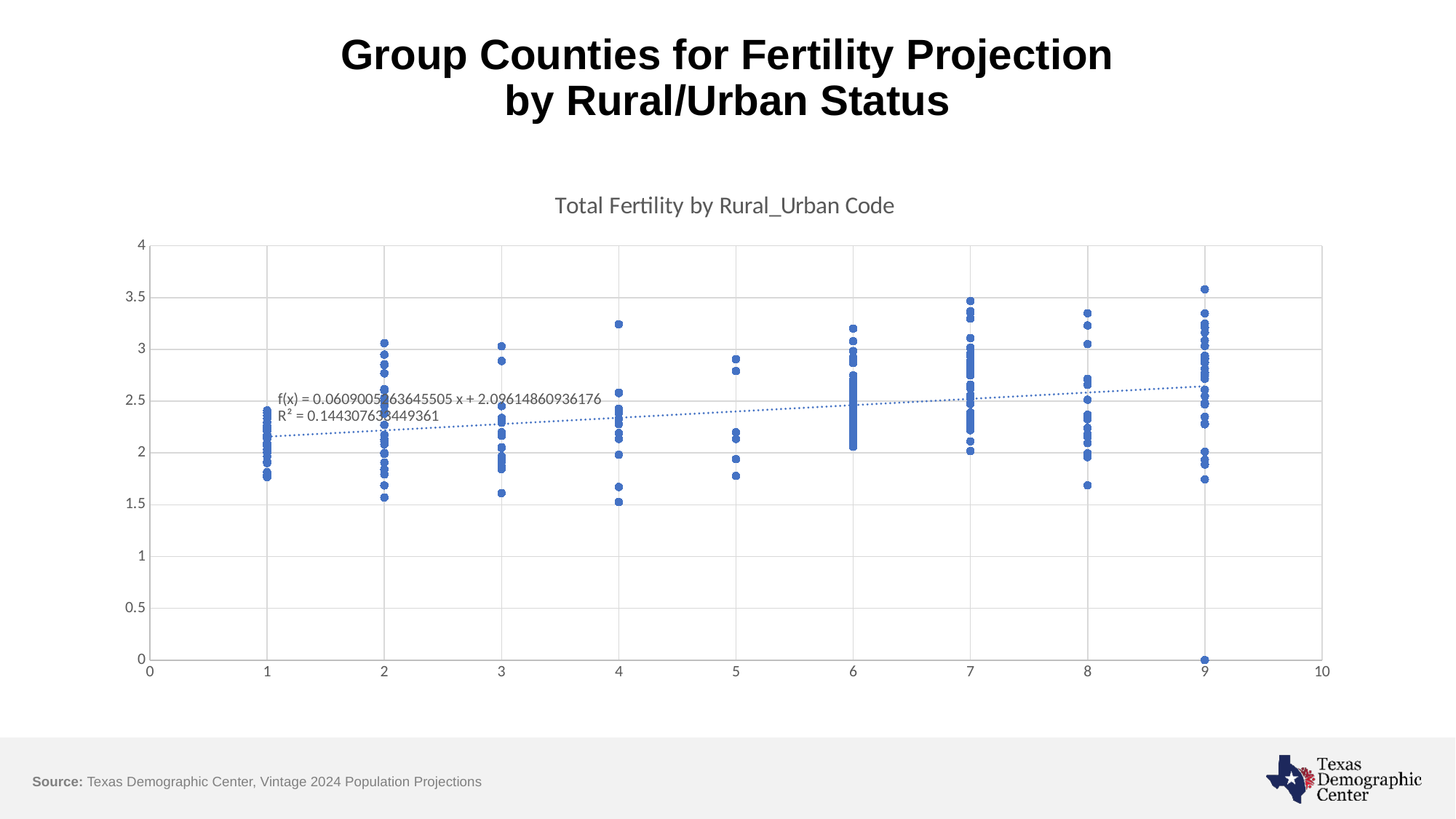
What kind of chart is shown on the slide? scatter plot Is the lowest value plotted for code 9 greater or less than 0.5? less Is the highest value plotted for code 7 greater or less than 3? greater Does the dotted trendline rise or fall as the Rural_Urban code increases? rises What is the title of the chart? Total Fertility by Rural_Urban Code How many Rural_Urban codes have data points plotted? 9 Which Rural_Urban code contains the lowest plotted total fertility value? 9 Is the lowest value plotted for code 1 greater or less than 1.5? greater What is the maximum value shown on the y axis? 4